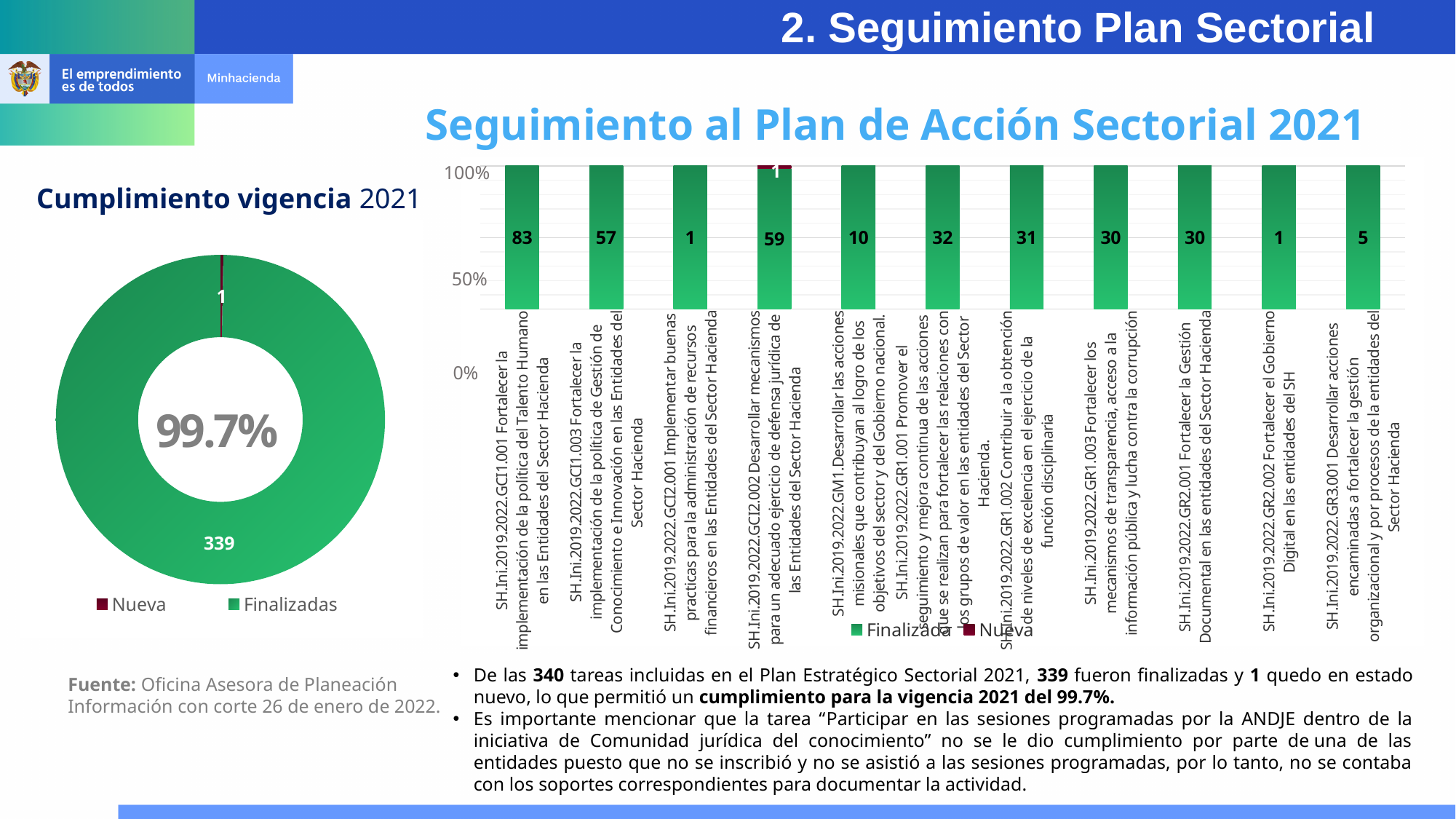
In the bar chart on the right, what is the difference between the Finalizada values for SH.Ini.2019.2022.GCI1.001 and SH.Ini.2019.2022.GCI1.003? 26 In the bar chart on the right, what is the Finalizada value for SH.Ini.2019.2022.GCI1.001? 83 In the bar chart on the right, how many categories are shown on the x axis? 11 In the bar chart on the right, what is the Finalizada value for SH.Ini.2019.2022.GR2.001? 30 In the donut chart titled 'Cumplimiento vigencia 2021', what is the total of Nueva and Finalizadas? 340 In the donut chart titled 'Cumplimiento vigencia 2021', what is the value for Finalizadas? 339 In the donut chart titled 'Cumplimiento vigencia 2021', what is the value for Nueva? 1 In the donut chart titled 'Cumplimiento vigencia 2021', what percentage is shown in the centre? 99.7% In the bar chart on the right, how many series does the legend list? 2 What kind of chart is shown on the right side of the slide? Stacked bar chart In the bar chart on the right, which category has the highest Finalizada value? SH.Ini.2019.2022.GCI1.001 In the donut chart titled 'Cumplimiento vigencia 2021', which slice is larger, Nueva or Finalizadas? Finalizadas